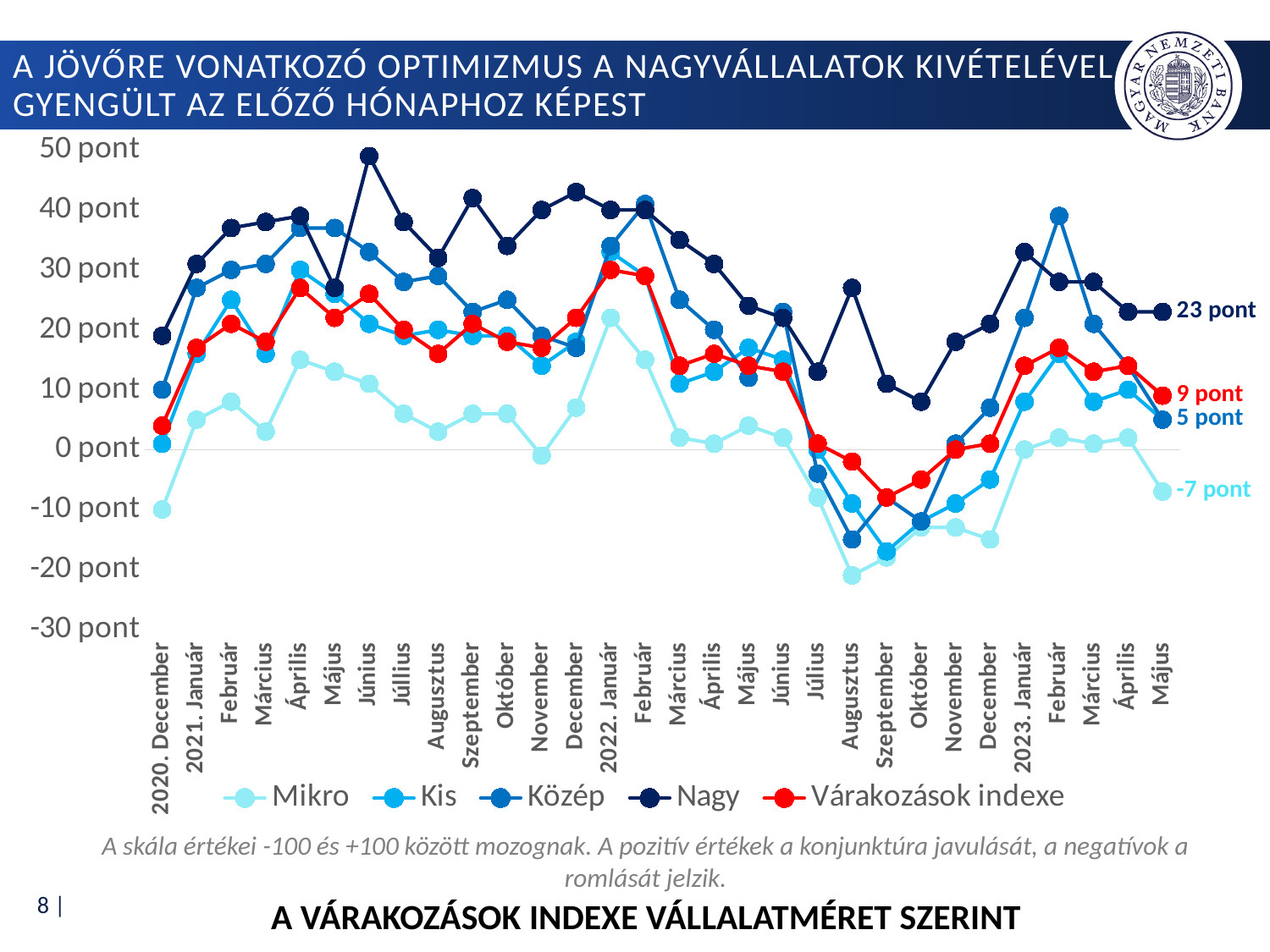
What kind of chart is shown on the slide? line chart What is the value of the Mikro series at 2023 Május? -7 pont What is the title of the chart shown at the bottom of the slide? A VÁRAKOZÁSOK INDEXE VÁLLALATMÉRET SZERINT Which series has the highest value at 2023 Május? Nagy Which series has the lowest value at 2023 Május? Mikro What is the value of the Nagy series at 2023 Május? 23 pont What is the difference between the Nagy and Mikro values at 2023 Május? 30 pont Is the value for Nagy at 2021 Június greater or less than 40 pont? greater How many series does the legend list? 5 What is the value of the Várakozások indexe series at 2023 Május? 9 pont At 2022 Augusztus, which is larger: the Nagy value or the Mikro value? Nagy Is the value for Mikro at 2022 Augusztus greater or less than -10 pont? less